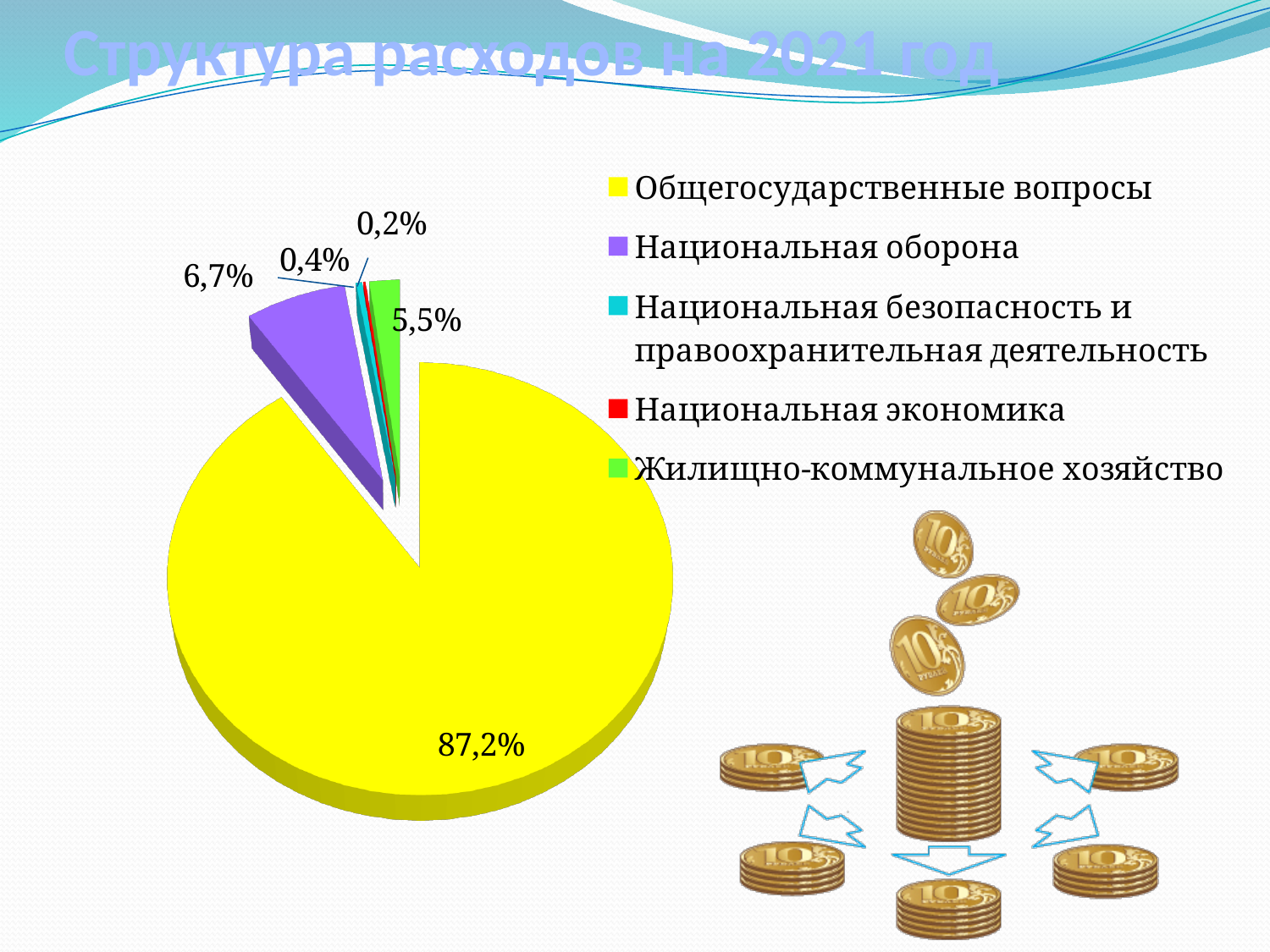
What share of expenditures goes to Национальная оборона? 6,7% What kind of chart is shown on the slide? pie chart What share of expenditures goes to Национальная безопасность и правоохранительная деятельность? 0,4% Which category has the smallest share of the pie? Национальная экономика What colour is the slice for Национальная оборона? purple Which category has the largest share of the pie? Общегосударственные вопросы How many categories does the legend list? 5 What share of expenditures goes to Жилищно-коммунальное хозяйство? 5,5% What is the difference between the shares for Национальная оборона and Жилищно-коммунальное хозяйство? 1,2% Which is larger: the share for Национальная оборона or for Жилищно-коммунальное хозяйство? Национальная оборона What share of expenditures goes to Национальная экономика? 0,2% What share of expenditures goes to Общегосударственные вопросы? 87,2%